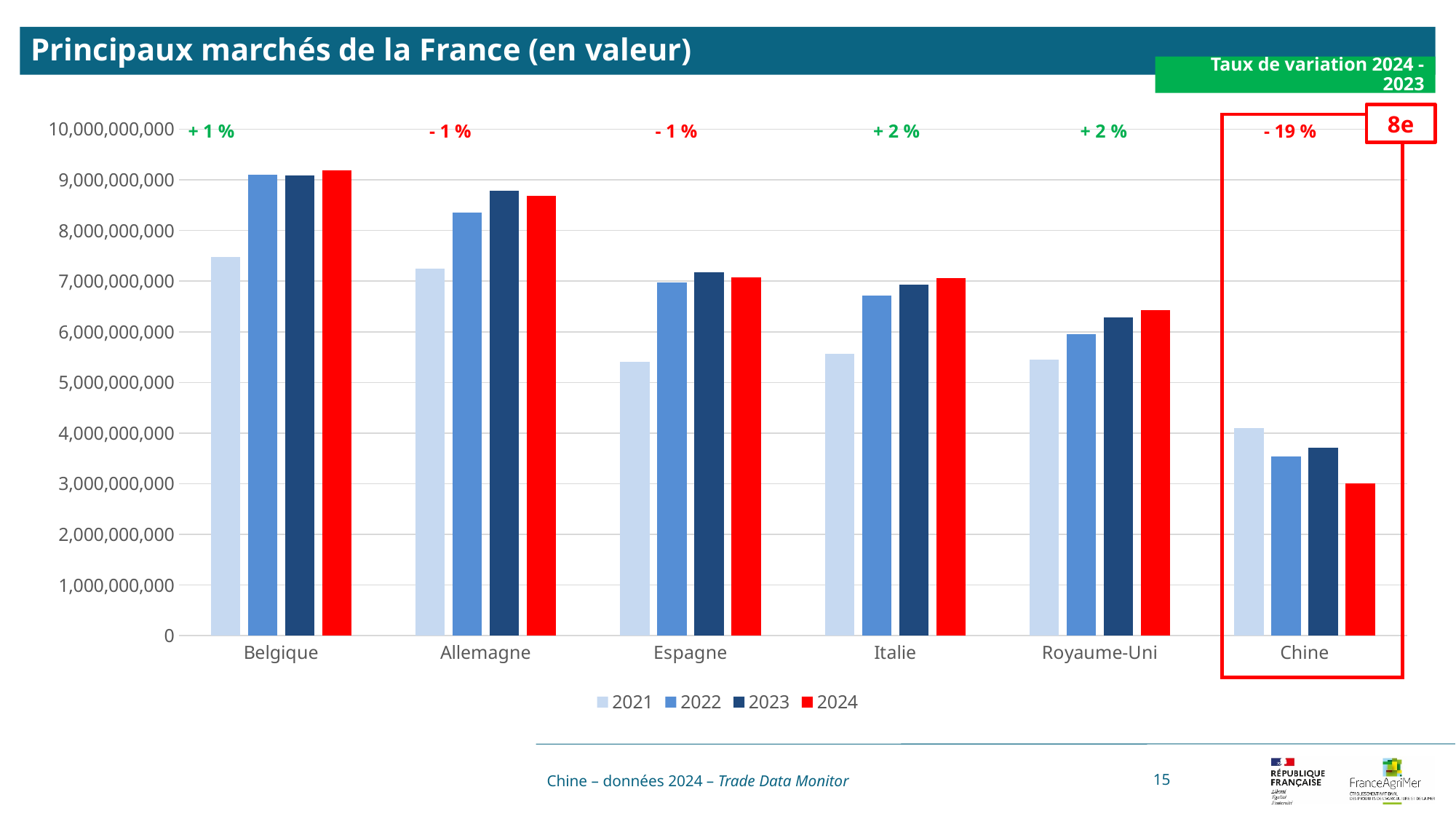
Is the 2024 value for Belgique greater or less than 9,000,000,000? greater Is the 2021 value for Espagne greater or less than 6,000,000,000? less Which country has the highest 2024 bar in the chart? Belgique Do the values for Italie rise or fall from 2021 to 2024? rise What variation rate 2024-2023 is printed above the Italie group? + 2 % What variation rate 2024-2023 is printed above the Chine group? - 19 % Which is larger, the 2024 value for Belgique or the 2024 value for Allemagne? Belgique What kind of chart is shown on the slide? bar chart Which country has the lowest 2024 bar in the chart? Chine How many series does the chart legend list? 4 How many countries are shown on the x axis of the chart? 6 What variation rate 2024-2023 is printed above the Belgique group? + 1 %